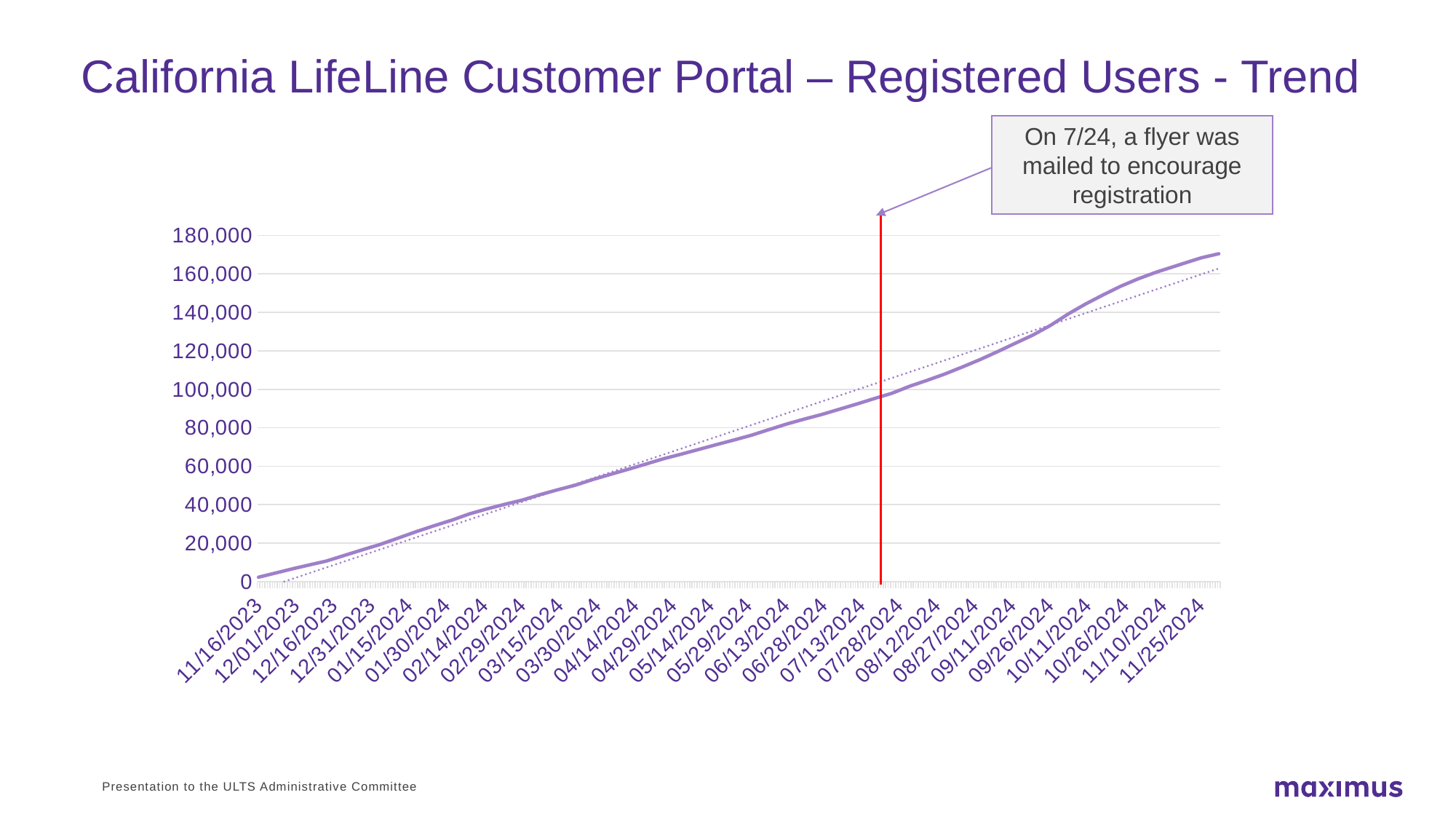
What kind of chart is shown on the slide? line chart Is the value for 09/26/2024 greater or less than 120,000? greater Which is larger, the value for 08/12/2024 or the value for 04/14/2024? 08/12/2024 Which date label on the x axis has the highest number of registered users? 11/25/2024 How many date labels are shown along the x axis? 26 Is the value for 11/25/2024 greater or less than 160,000? greater Do the registered user values rise or fall from 11/16/2023 to 11/25/2024? rise Is the value for 11/16/2023 greater or less than 20,000? less According to the annotation on the chart, on what date was a flyer mailed to encourage registration? 7/24 Which date label on the x axis has the lowest number of registered users? 11/16/2023